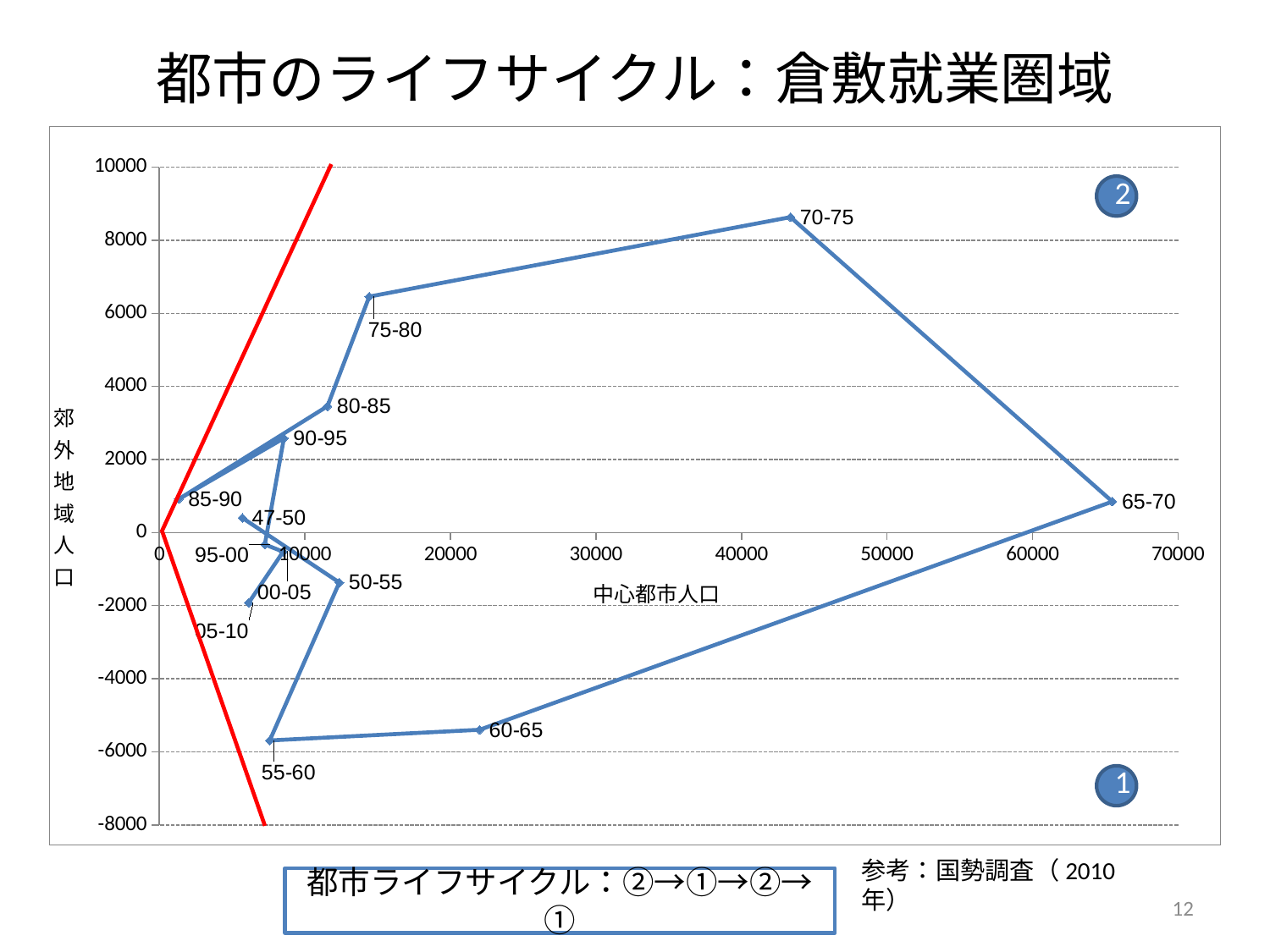
What is the label of the x axis? 中心都市人口 Which has the larger 郊外地域人口 value, 70-75 or 65-70? 70-75 Is the 郊外地域人口 value for 70-75 greater or less than 8000? greater Which period has the highest 中心都市人口 (x-axis) value? 65-70 Is the 郊外地域人口 value for 55-60 greater or less than -4000? less What is the label of the y axis? 郊外地域人口 What kind of chart is shown on the slide? Scatter (line) chart Which period has the highest 郊外地域人口 (y-axis) value? 70-75 Which period has the lowest 郊外地域人口 (y-axis) value? 55-60 Is the 中心都市人口 value for 85-90 greater or less than 10000? less How many labeled data points (periods) are plotted on the chart? 13